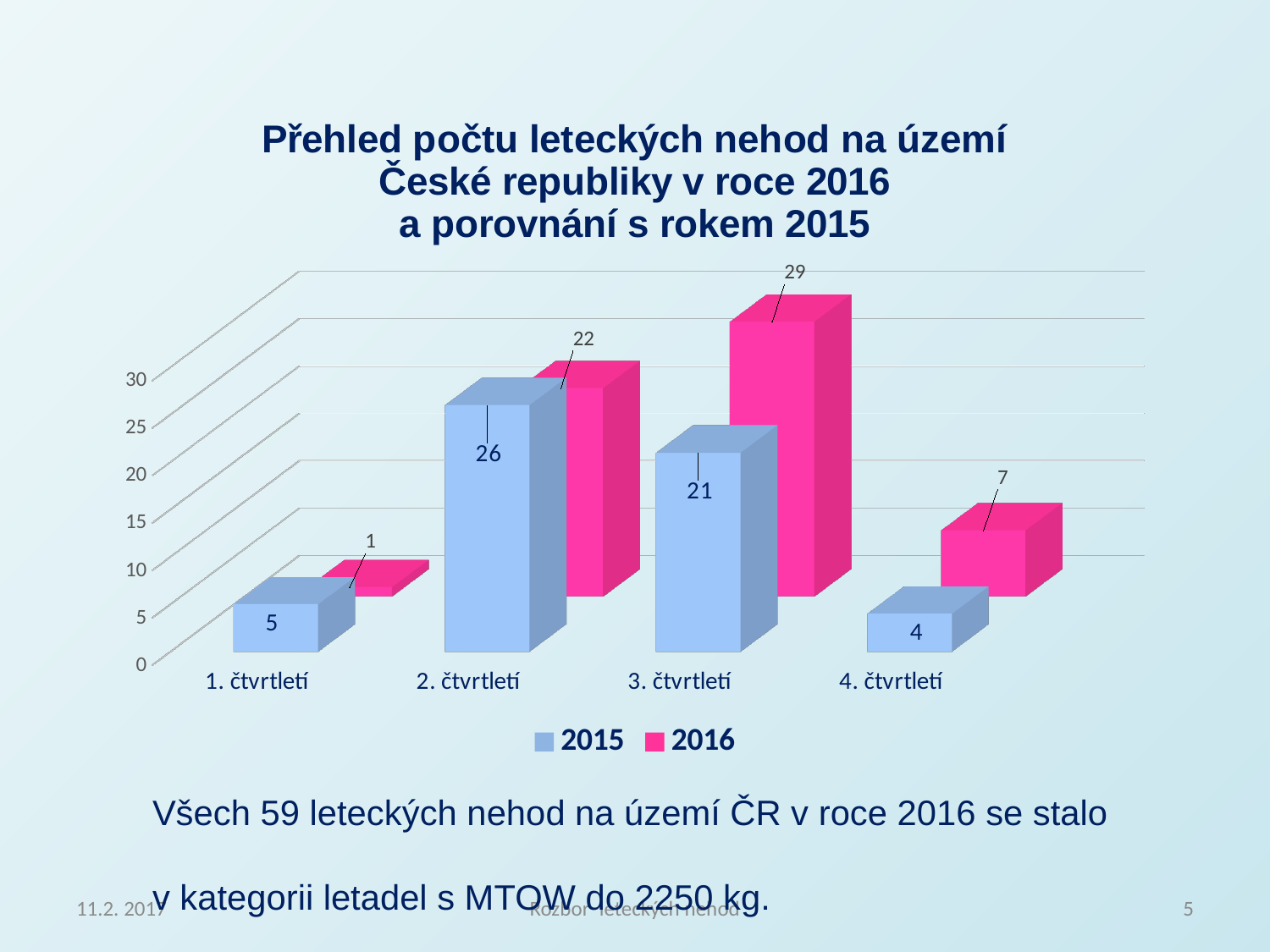
What is the value for 2016 in 3. čtvrtletí? 29 What is the value for 2016 in 1. čtvrtletí? 1 What kind of chart is shown on the slide? bar chart How many series does the legend list? 2 In which quarter is the 2015 value lowest? 4. čtvrtletí What is the difference between the 2016 and 2015 values in 3. čtvrtletí? 8 Which colour represents the 2016 series in the legend? pink Which is larger in 2. čtvrtletí, the 2015 value or the 2016 value? 2015 What is the value for 2015 in 4. čtvrtletí? 4 In which quarter is the 2016 value highest? 3. čtvrtletí How many quarters (categories) are shown on the x axis? 4 What is the value for 2015 in 2. čtvrtletí? 26